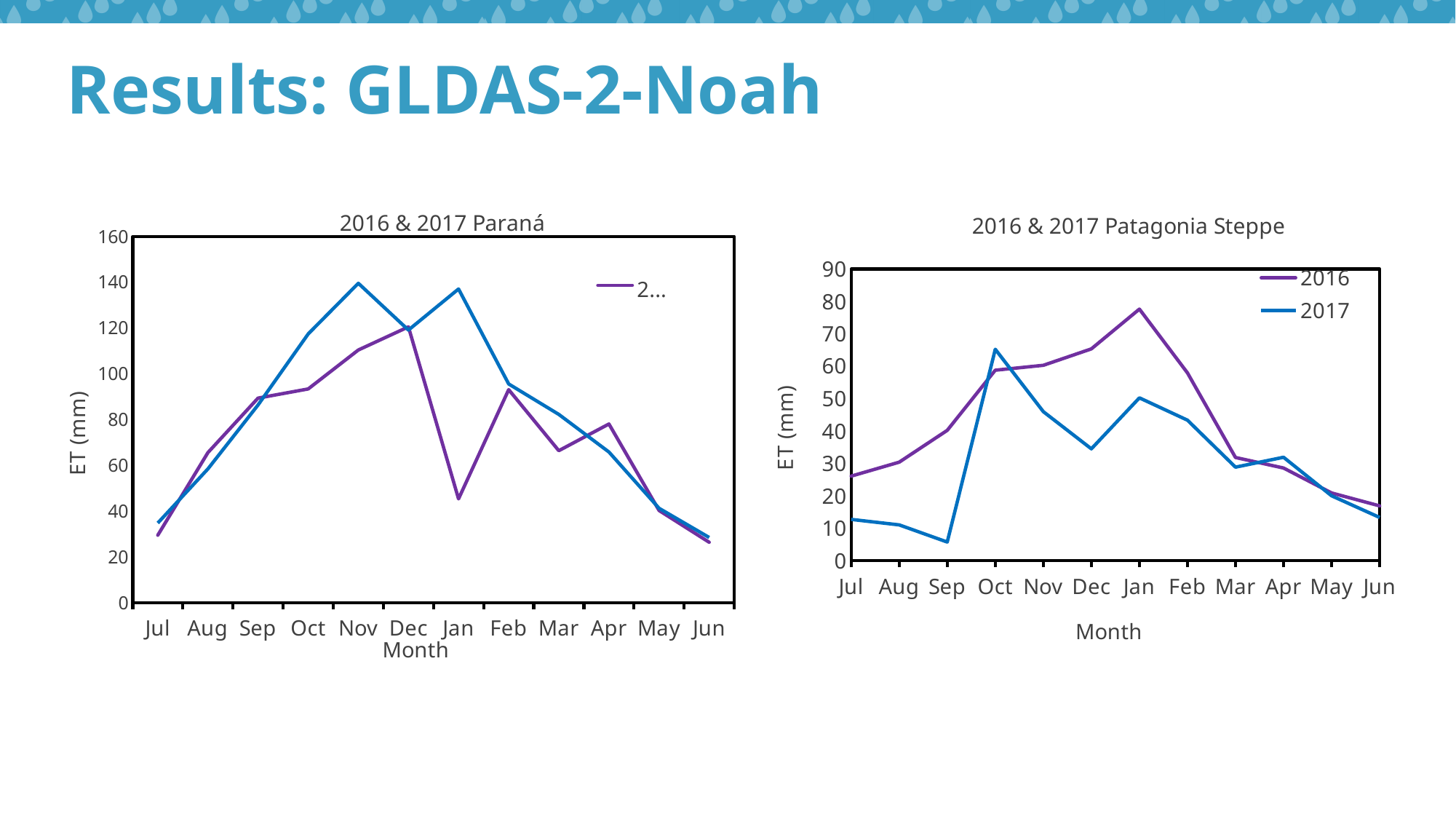
In the '2016 & 2017 Paraná' chart, is the 2016 value for Jan greater or less than 60? less What kind of chart is the '2016 & 2017 Paraná' chart? line chart In the '2016 & 2017 Patagonia Steppe' chart, how many series does the legend list? 2 In the '2016 & 2017 Paraná' chart, which series has the larger value in Jan, 2016 or 2017? 2017 In the '2016 & 2017 Patagonia Steppe' chart, which month has the lowest value for the 2017 series? Sep In the '2016 & 2017 Patagonia Steppe' chart, is the 2016 value for Jan greater or less than 70? greater In the '2016 & 2017 Paraná' chart, is the 2017 value for Nov greater or less than 120? greater How many months are plotted along the x axis of the '2016 & 2017 Paraná' chart? 12 In the '2016 & 2017 Patagonia Steppe' chart, which month has the highest value for the 2017 series? Oct In the '2016 & 2017 Patagonia Steppe' chart, which series has the larger value in Dec, 2016 or 2017? 2016 In the '2016 & 2017 Patagonia Steppe' chart, which month has the highest value for the 2016 series? Jan What is the y-axis label on the '2016 & 2017 Patagonia Steppe' chart? ET (mm)